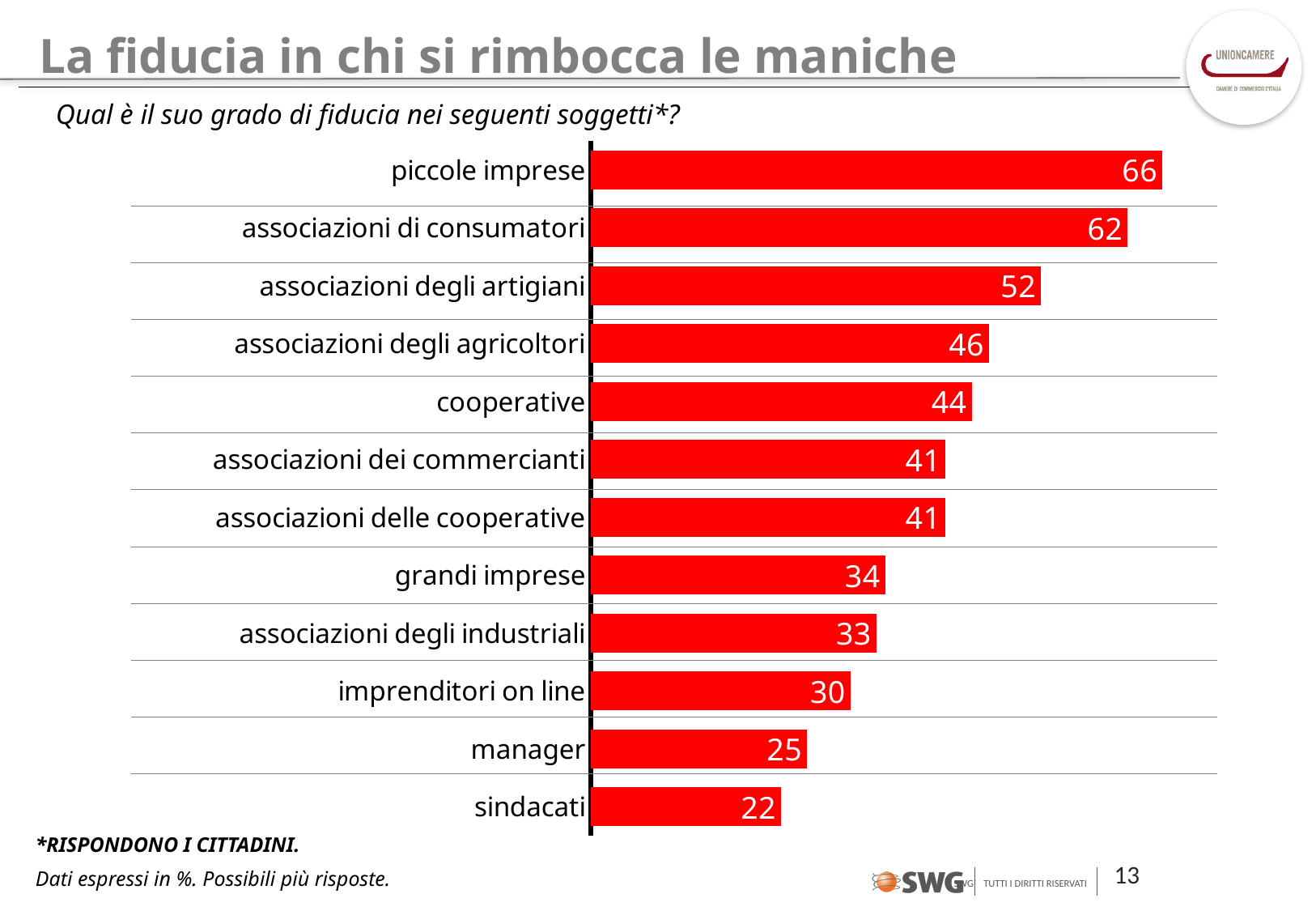
Which is larger, the value for associazioni degli artigiani or the value for associazioni degli agricoltori? associazioni degli artigiani What is the difference between the values for grandi imprese and manager? 9 Which category has the lowest value? sindacati What is the difference between the values for piccole imprese and associazioni di consumatori? 4 What is the value for imprenditori on line? 30 Which category has the highest value? piccole imprese How many categories are shown in the chart? 12 What is the value for sindacati? 22 What is the value for cooperative? 44 What colour are the bars in the chart? red What kind of chart is shown on the slide? bar chart What is the value for piccole imprese? 66